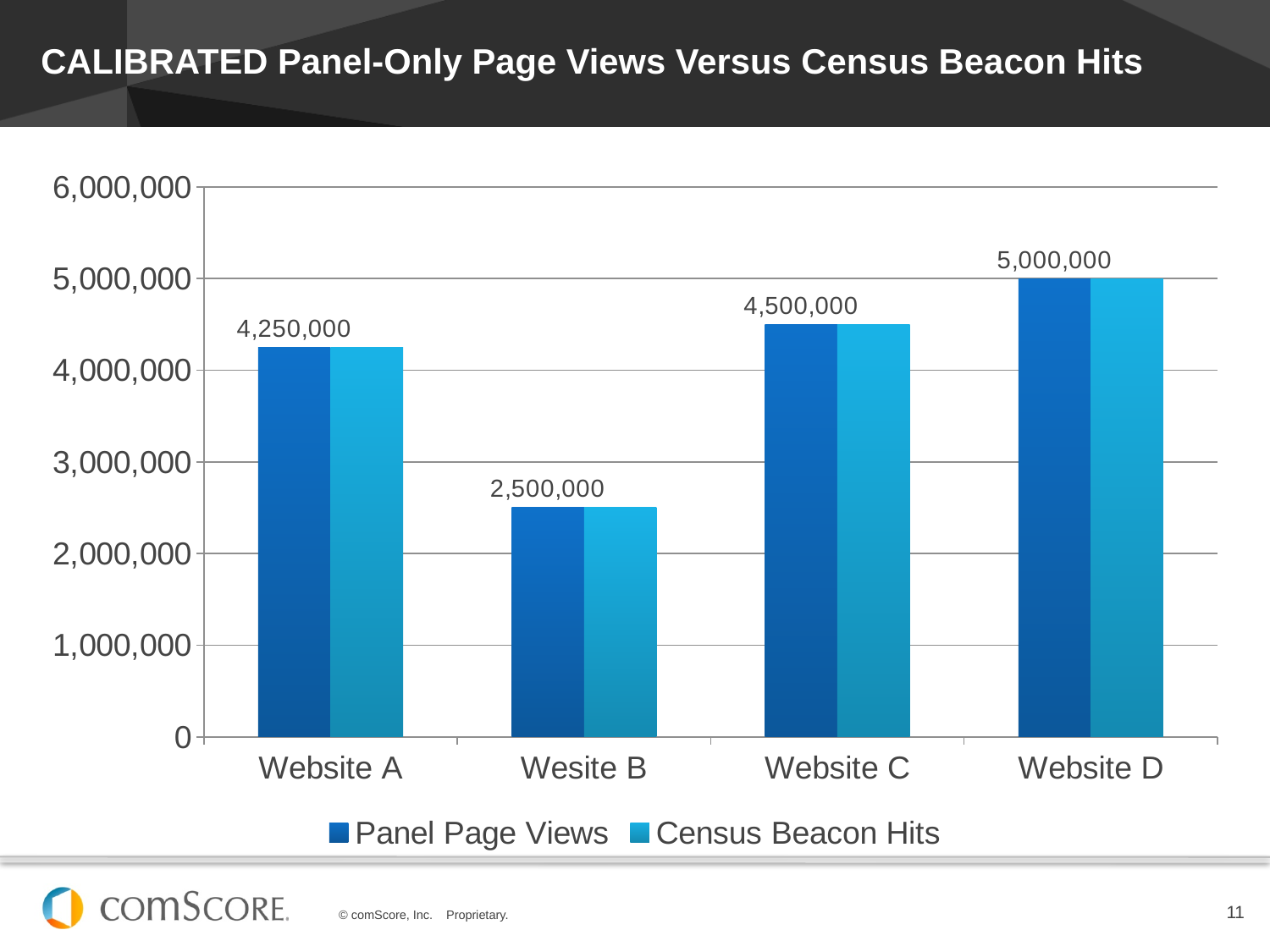
What is the difference between the labelled values for Website D and Website A? 750,000 How many websites are shown on the x axis? 4 What value is labelled for Wesite B? 2,500,000 Which website has the lowest value? Wesite B Is the Census Beacon Hits value for Wesite B greater or less than 3,000,000? less Which is larger, the value for Website C or the value for Wesite B? Website C How many series does the legend list? 2 What value is labelled for Website A? 4,250,000 Which website has the highest value? Website D What value is labelled for Website D? 5,000,000 What kind of chart is shown? bar chart What value is labelled for Website C? 4,500,000